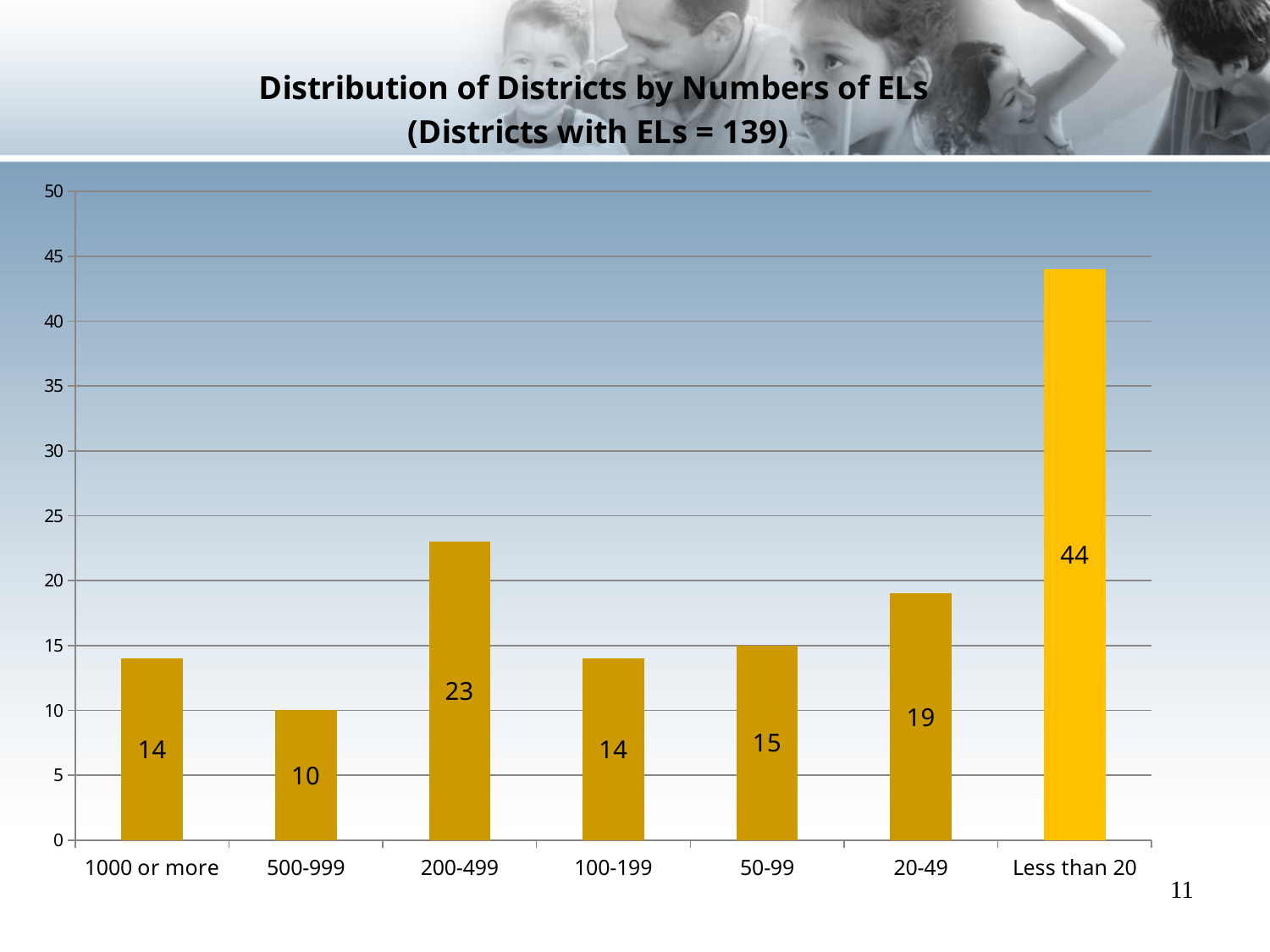
What is the value for the "500-999" category? 10 Which category has the lowest value? 500-999 How many categories are shown on the x axis? 7 What is the value for the "Less than 20" category? 44 What is the value for the "200-499" category? 23 What is the difference between the values for "Less than 20" and "200-499"? 21 Which category has the highest value? Less than 20 Is the value for "Less than 20" greater or less than 40? greater What is the value for the "20-49" category? 19 What is the title of the chart? Distribution of Districts by Numbers of ELs (Districts with ELs = 139) Which is larger, the value for "50-99" or the value for "20-49"? 20-49 What kind of chart is shown on the slide? Bar chart